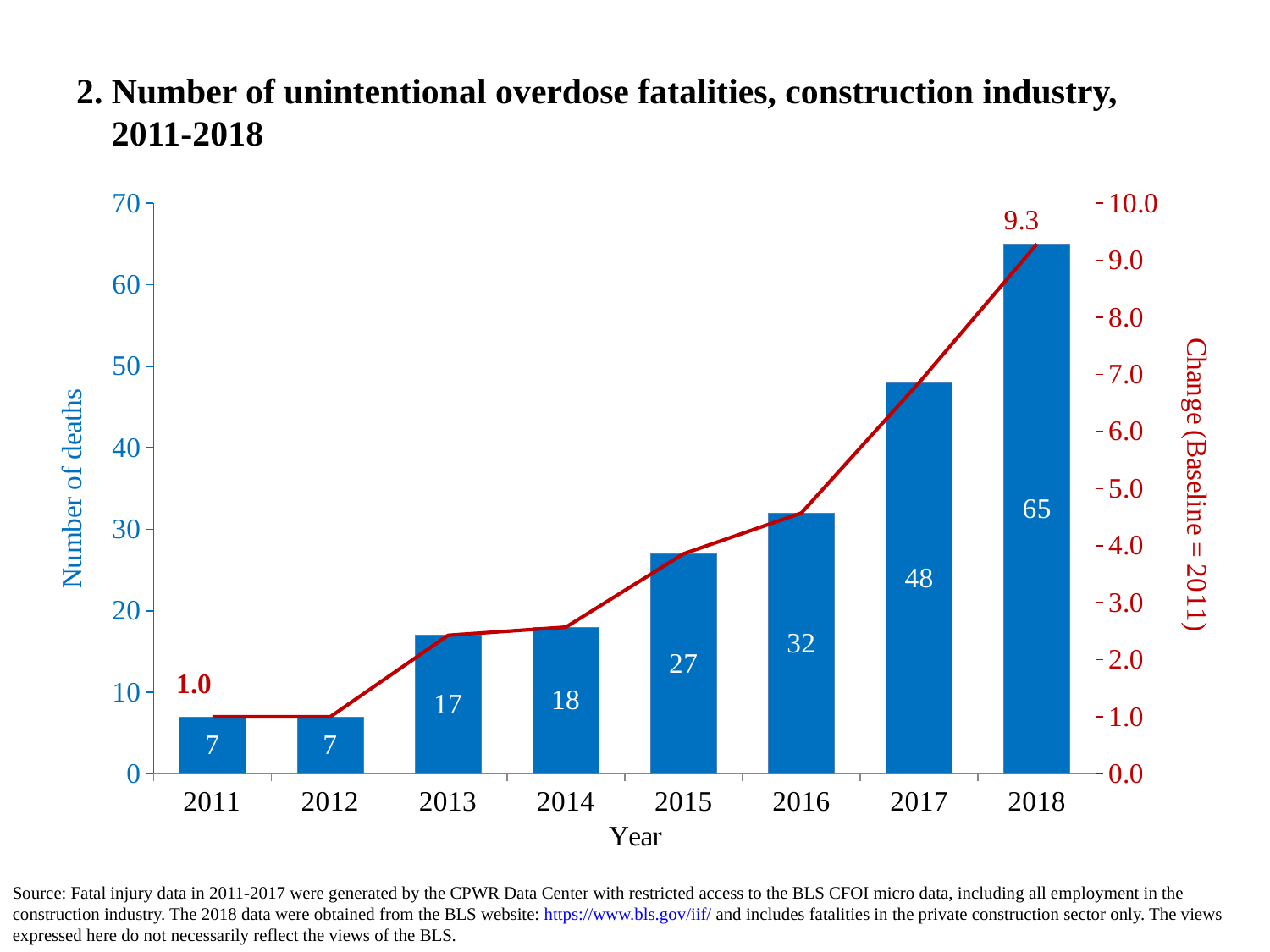
What type of chart is used to show the number of deaths? Bar chart Which year has the highest number of deaths? 2018 How many years are shown on the x axis? 8 What is the change value (baseline = 2011) labelled on the line for 2018? 9.3 What is the label of the right-hand vertical axis? Change (Baseline = 2011) Which years have the lowest number of deaths? 2011 and 2012 Is the change value (baseline = 2011) for 2017 greater or less than 6.0? greater What is the difference in the number of deaths between 2018 and 2017? 17 What is the difference in the number of deaths between 2016 and 2015? 5 What is the number of deaths shown for 2013? 17 How many unintentional overdose fatalities were there in the construction industry in 2017? 48 Which year had more deaths, 2014 or 2016? 2016